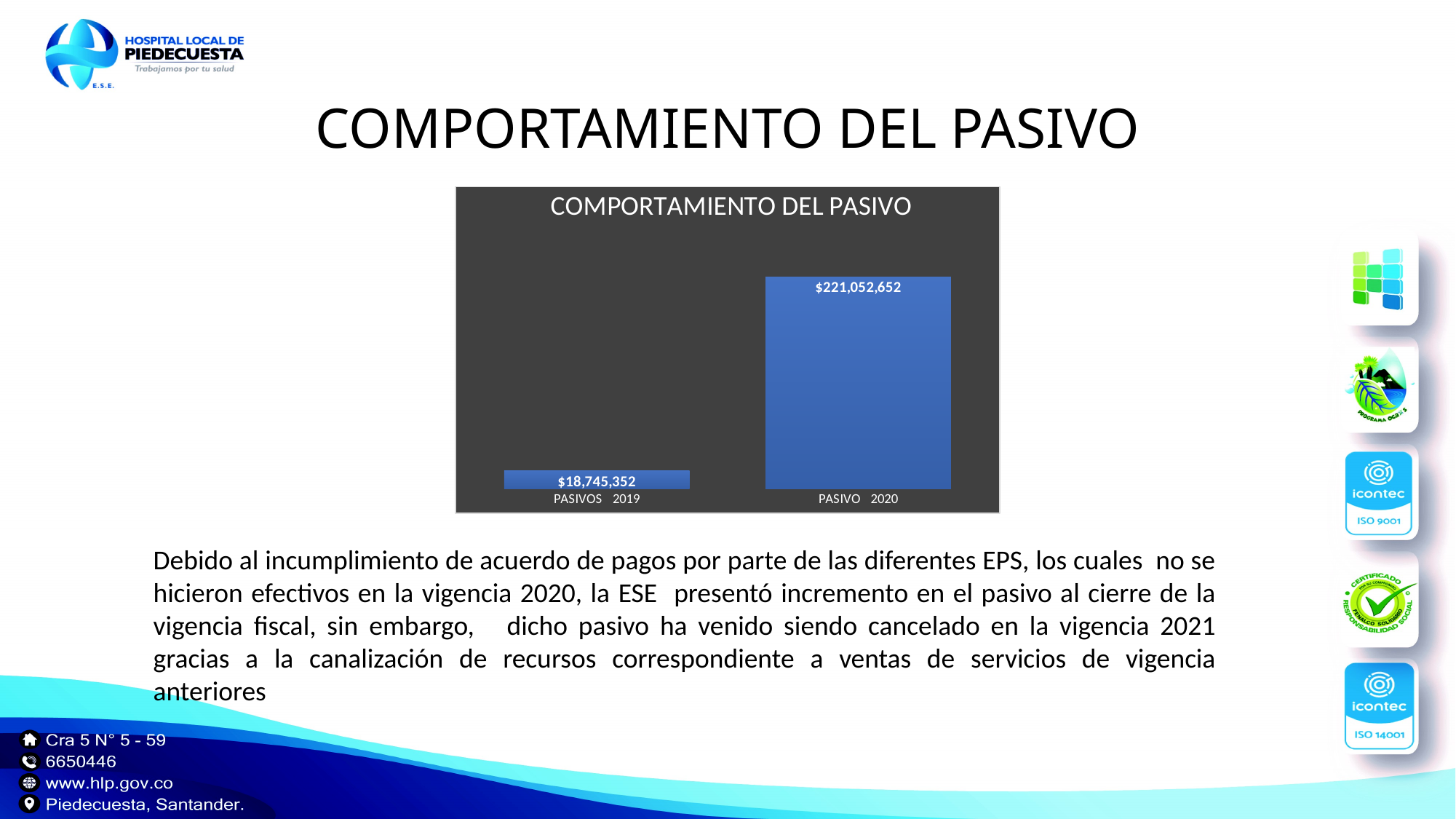
What is the title of the chart? COMPORTAMIENTO DEL PASIVO Do the values rise or fall from PASIVOS 2019 to PASIVO 2020? Rise What is the difference between the value for PASIVO 2020 and the value for PASIVOS 2019? $202,307,300 What is the value for PASIVO 2020? $221,052,652 What colour are the bars in the chart? Blue Which is larger, the value for PASIVOS 2019 or the value for PASIVO 2020? PASIVO 2020 What kind of chart is shown on the slide? Bar chart Which category has the highest value? PASIVO 2020 What is the value for PASIVOS 2019? $18,745,352 How many categories are shown in the chart? 2 Which category has the lowest value? PASIVOS 2019